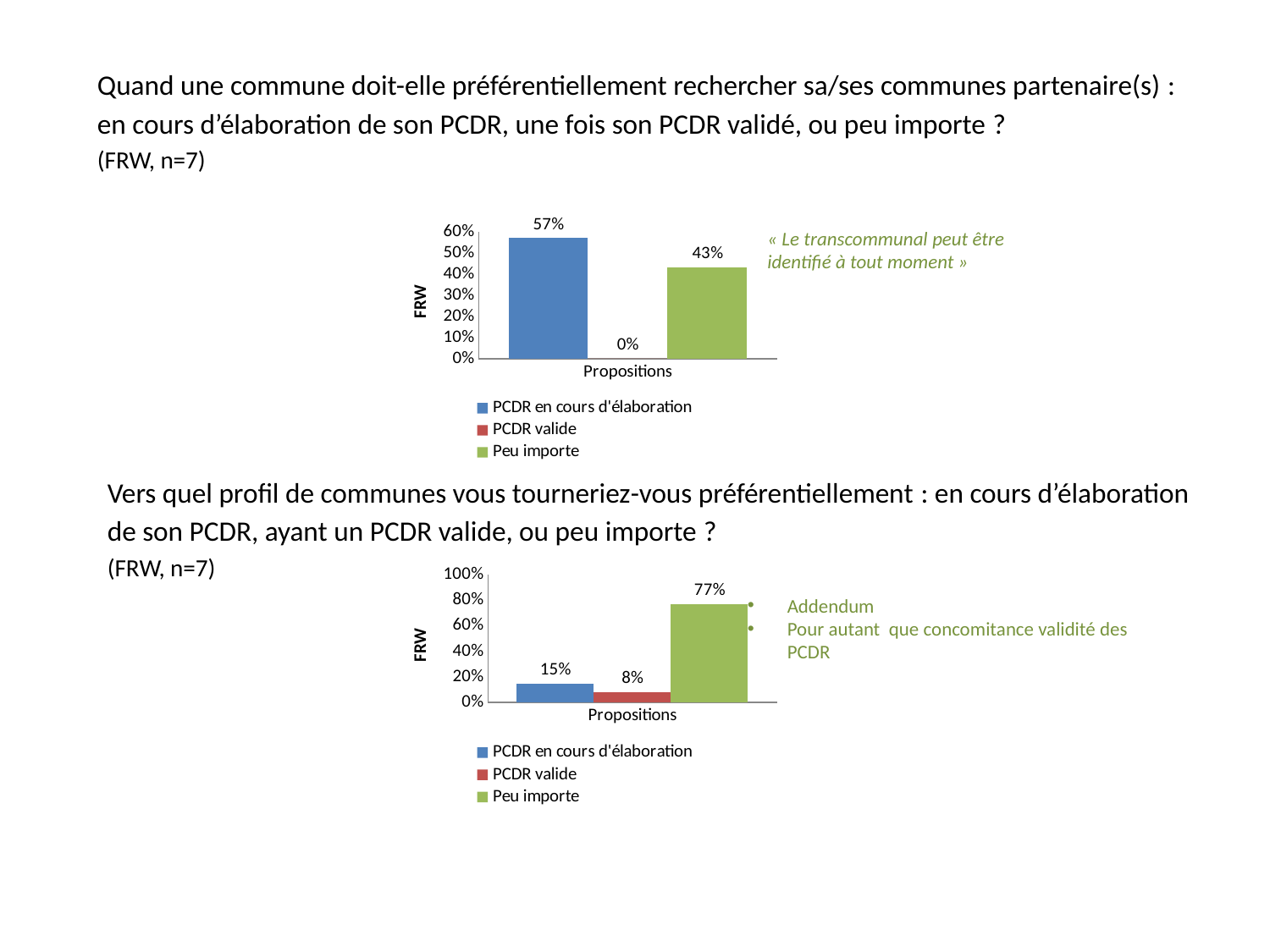
What kind of chart is the top chart? Bar chart In the top chart, what is the difference between PCDR en cours d'élaboration and Peu importe? 14% In the bottom chart, what is the value for Peu importe? 77% In the bottom chart, what is the value for PCDR valide? 8% In the bottom chart, which is larger, PCDR en cours d'élaboration or PCDR valide? PCDR en cours d'élaboration In the top chart, which series has the highest value? PCDR en cours d'élaboration In the top chart, what is the value for Peu importe? 43% How many series does the legend of the bottom chart list? 3 In the top chart, what is the value for PCDR valide? 0% In the top chart, what is the value for PCDR en cours d'élaboration? 57% In the bottom chart, which series has the lowest value? PCDR valide In the bottom chart, what is the difference between Peu importe and PCDR en cours d'élaboration? 62%